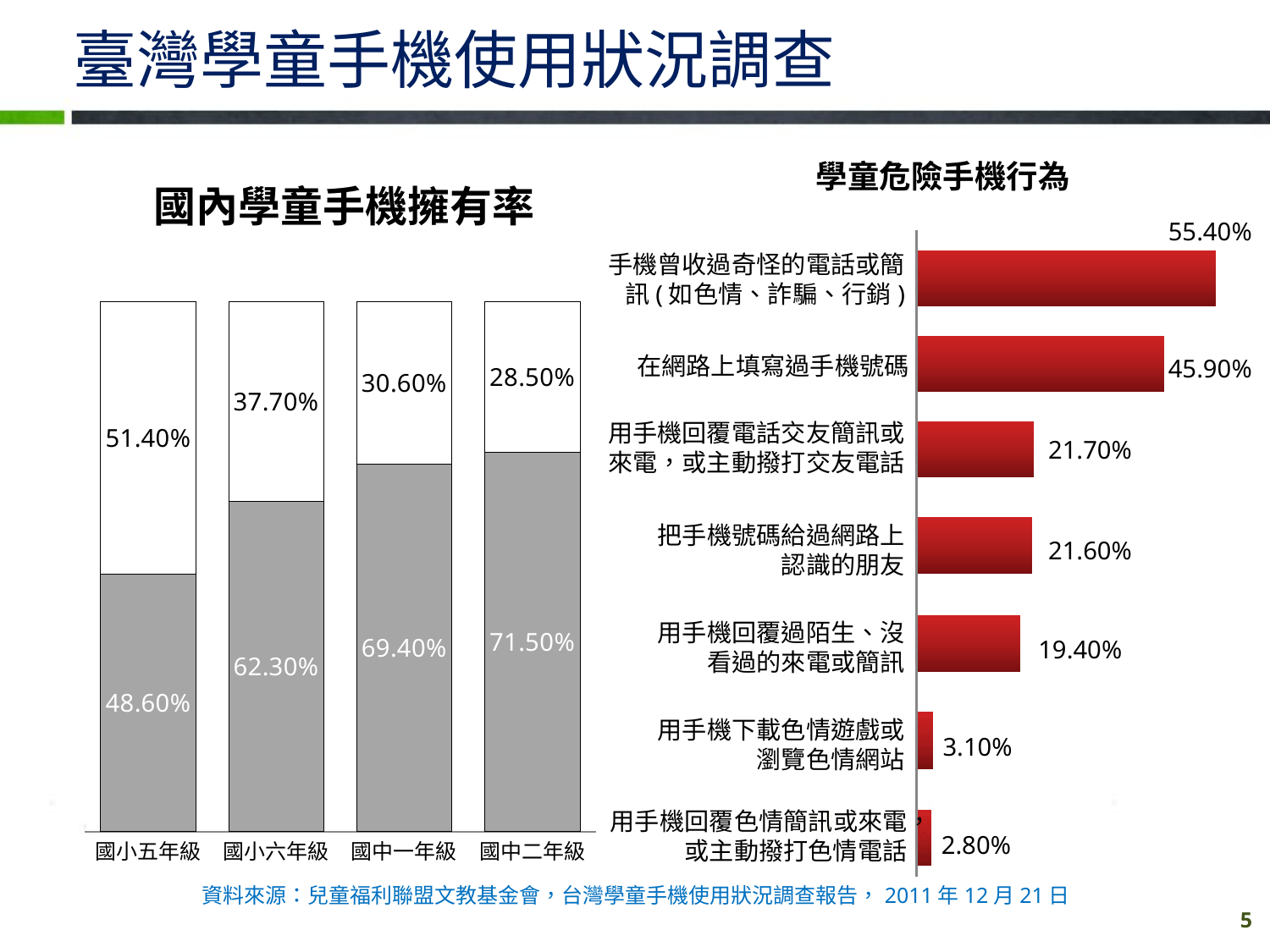
In the chart titled 國內學童手機擁有率, what is the value of the gray (lower) segment for 國中二年級? 71.50% In the chart titled 國內學童手機擁有率, which category has the highest gray (lower) segment value? 國中二年級 In the chart titled 國內學童手機擁有率, do the gray (lower) segment values rise or fall from 國小五年級 to 國中二年級? rise In the chart titled 國內學童手機擁有率, what is the value of the white (upper) segment for 國小五年級? 51.40% In the chart titled 學童危險手機行為, which category has the highest value? 手機曾收過奇怪的電話或簡訊(如色情、詐騙、行銷) In the chart titled 學童危險手機行為, what is the difference between the values for 手機曾收過奇怪的電話或簡訊(如色情、詐騙、行銷) and 在網路上填寫過手機號碼? 9.50% In the chart titled 學童危險手機行為, what is the value for 在網路上填寫過手機號碼? 45.90% What kind of chart is the chart titled 學童危險手機行為? bar chart In the chart titled 國內學童手機擁有率, how many categories are shown on the x axis? 4 In the chart titled 學童危險手機行為, how many categories are shown? 7 In the chart titled 國內學童手機擁有率, what is the total of the two segments for 國小六年級? 100.00% In the chart titled 學童危險手機行為, which category has the lowest value? 用手機回覆色情簡訊或來電，或主動撥打色情電話